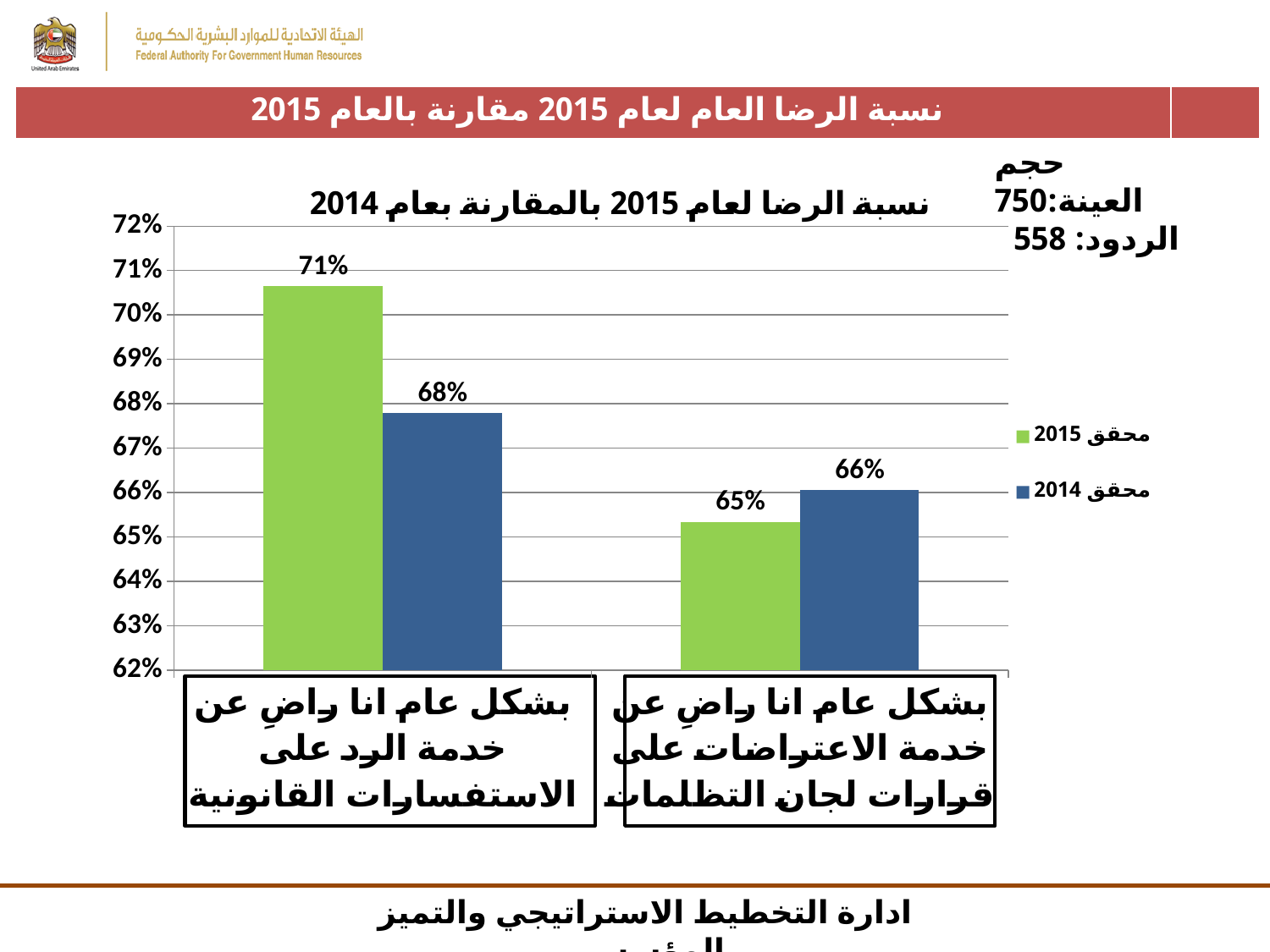
Is the value for محقق 2015 for the category 'بشكل عام انا راضٍ عن خدمة الرد على الاستفسارات القانونية' greater or less than 70%? greater Which category has the highest value for محقق 2015? بشكل عام انا راضٍ عن خدمة الرد على الاستفسارات القانونية What is the value for محقق 2015 for the category 'بشكل عام انا راضٍ عن خدمة الاعتراضات على قرارات لجان التظلمات'? 65% For the category 'بشكل عام انا راضٍ عن خدمة الاعتراضات على قرارات لجان التظلمات', which is larger: محقق 2015 or محقق 2014? محقق 2014 Which category has the lowest value for محقق 2014? بشكل عام انا راضٍ عن خدمة الاعتراضات على قرارات لجان التظلمات How many series does the chart legend list? 2 How many categories are shown on the x axis of the chart? 2 What is the value for محقق 2014 for the category 'بشكل عام انا راضٍ عن خدمة الرد على الاستفسارات القانونية'? 68% What is the value for محقق 2015 for the category 'بشكل عام انا راضٍ عن خدمة الرد على الاستفسارات القانونية'? 71% What is the difference between the محقق 2015 and محقق 2014 values for the category 'بشكل عام انا راضٍ عن خدمة الرد على الاستفسارات القانونية'? 3% What is the value for محقق 2014 for the category 'بشكل عام انا راضٍ عن خدمة الاعتراضات على قرارات لجان التظلمات'? 66% What kind of chart is shown on the slide? bar chart